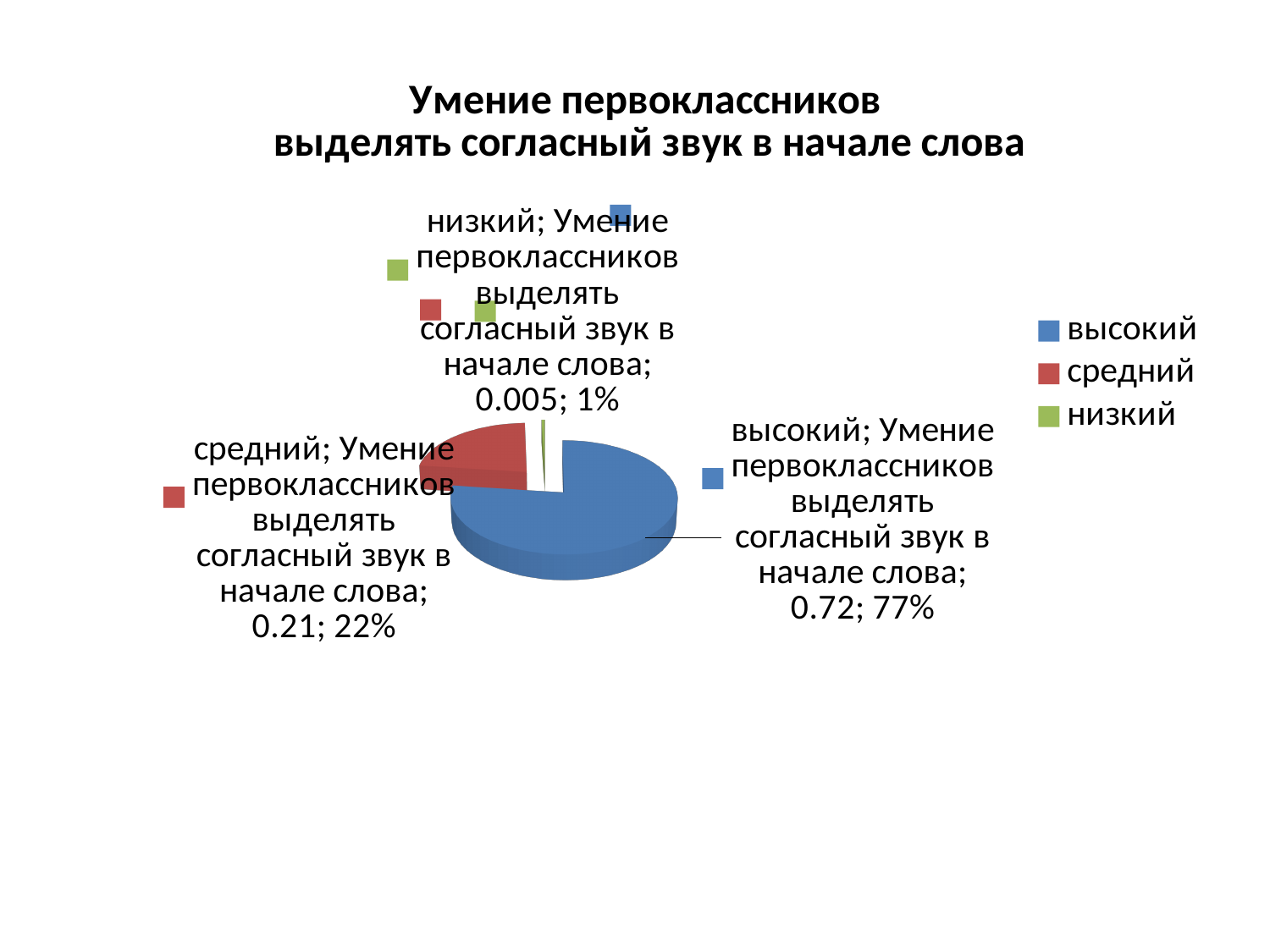
What value is shown for the "высокий" slice? 0.72 What value is shown for the "средний" slice? 0.21 What value is shown for the "низкий" slice? 0.005 What percentage share of the pie does the "низкий" slice have? 1% Which is larger, the value for "средний" or the value for "низкий"? средний What percentage share of the pie does the "средний" slice have? 22% Which category has the largest slice of the pie? высокий Which category has the smallest slice of the pie? низкий How many slices does the pie chart have? 3 What percentage share of the pie does the "высокий" slice have? 77% How many entries does the legend list? 3 What kind of chart is shown on the slide? pie chart